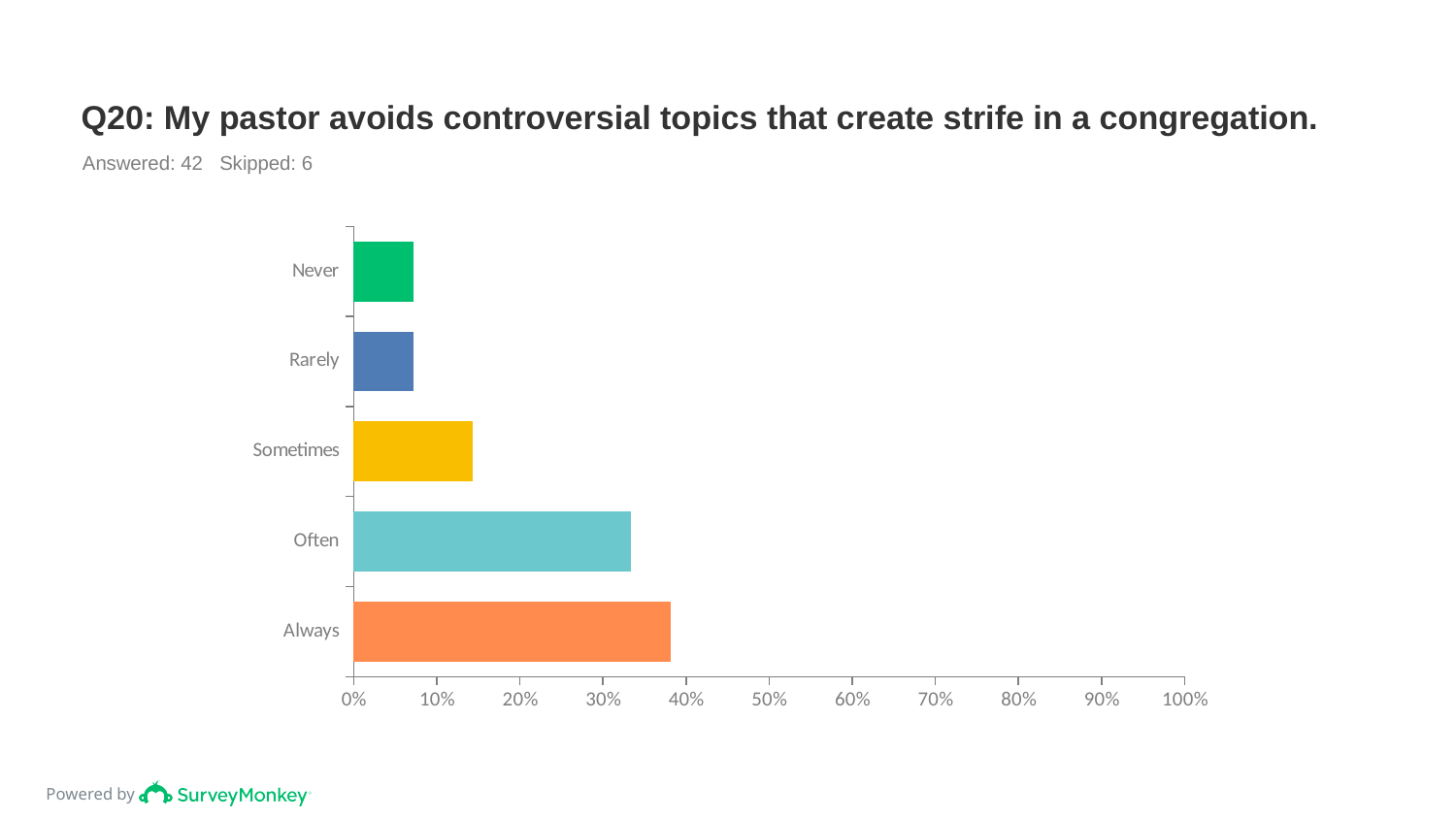
Which is larger, the value for Always or the value for Often? Always Is the value for Sometimes greater or less than 20%? less Which is larger, the value for Sometimes or the value for Often? Often Is the value for Never greater or less than 10%? less Which response category has the highest value? Always What is the title of the chart? Q20: My pastor avoids controversial topics that create strife in a congregation. Is the value for Often greater or less than 20%? greater What kind of chart is shown on the slide? Bar chart How many response categories are plotted in the chart? 5 Going down the categories from Never to Always, do the bars generally get longer or shorter? longer